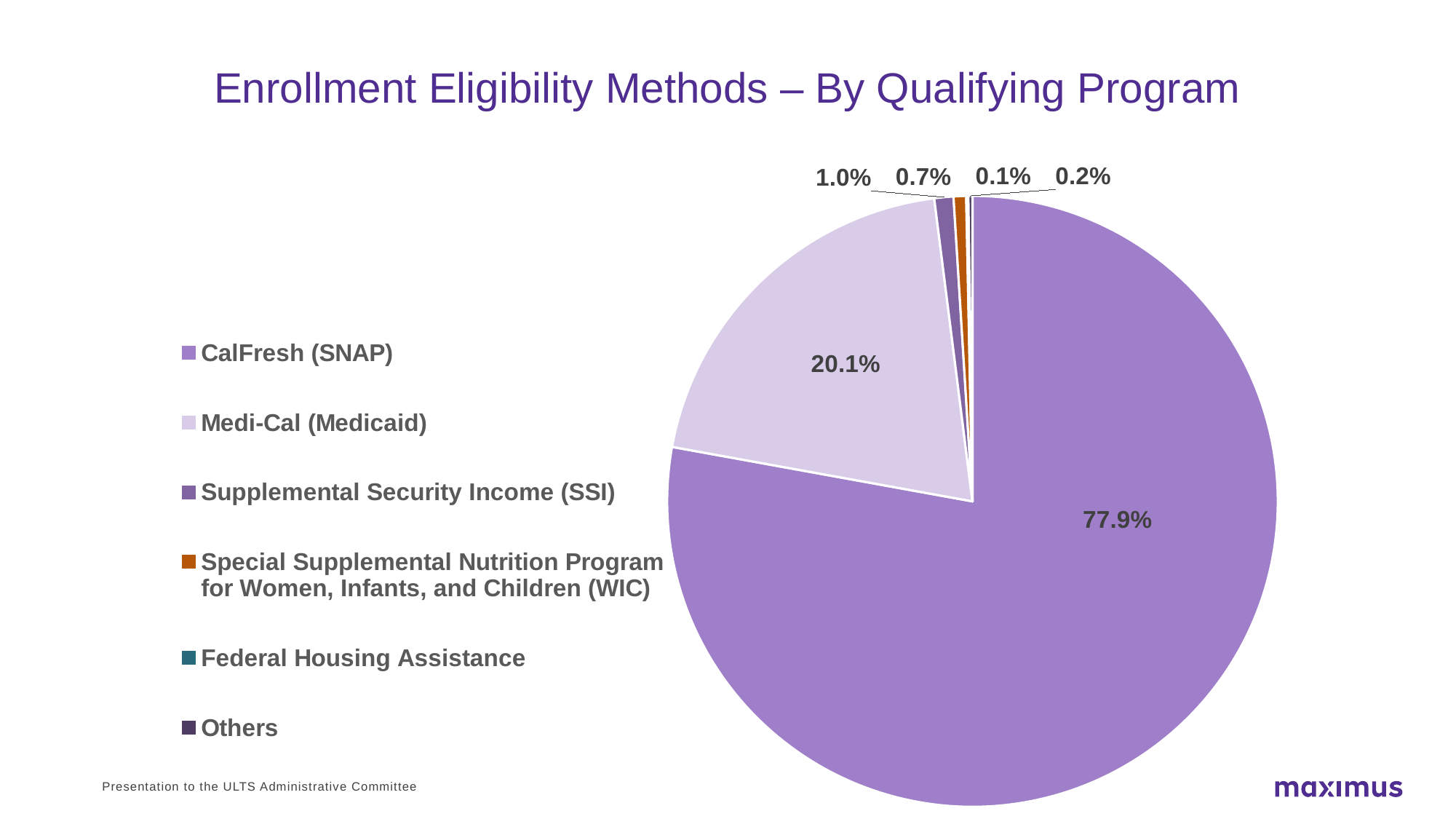
What is the value shown for Supplemental Security Income (SSI)? 1.0% How many categories does the legend list? 6 Which qualifying program has the smallest slice of the pie? Federal Housing Assistance What colour is the slice for the Special Supplemental Nutrition Program for Women, Infants, and Children (WIC)? orange What is the value shown for Medi-Cal (Medicaid)? 20.1% What type of chart is shown on the slide? pie chart What is the value shown for the Special Supplemental Nutrition Program for Women, Infants, and Children (WIC)? 0.7% Which is larger, the share for Supplemental Security Income (SSI) or the share for WIC? Supplemental Security Income (SSI) What is the title of the chart? Enrollment Eligibility Methods – By Qualifying Program What share of the pie does CalFresh (SNAP) account for? 77.9% Which qualifying program has the largest slice of the pie? CalFresh (SNAP) What is the difference between the CalFresh (SNAP) share and the Medi-Cal (Medicaid) share? 57.8%